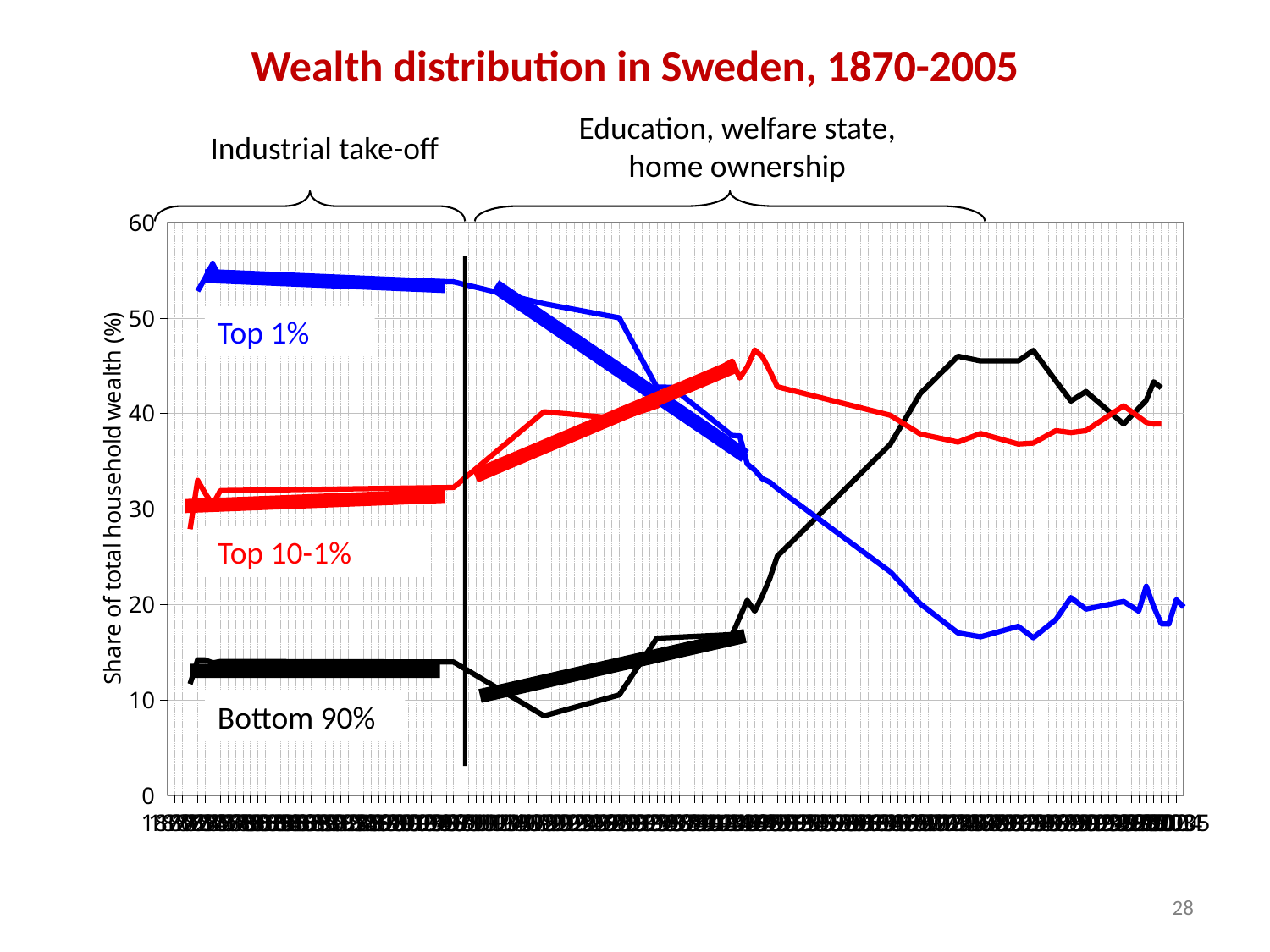
Does the Top 1% series rise or fall overall from left to right across the chart? fall Is the value for Top 1% at the right end of the chart greater or less than 30? less Which series has the highest value at the left end of the chart? Top 1% What is the title of the chart? Wealth distribution in Sweden, 1870-2005 Does the Bottom 90% series rise or fall overall from left to right across the chart? rise Is the value for Bottom 90% at the right end of the chart greater or less than 30? greater Is the value for Top 1% at the left end of the chart greater or less than 50? greater What kind of chart is shown on the slide? line chart At the right end of the chart, which is larger: Top 1% or Bottom 90%? Bottom 90% What is the label of the vertical axis? Share of total household wealth (%) How many series are plotted on the chart? 3